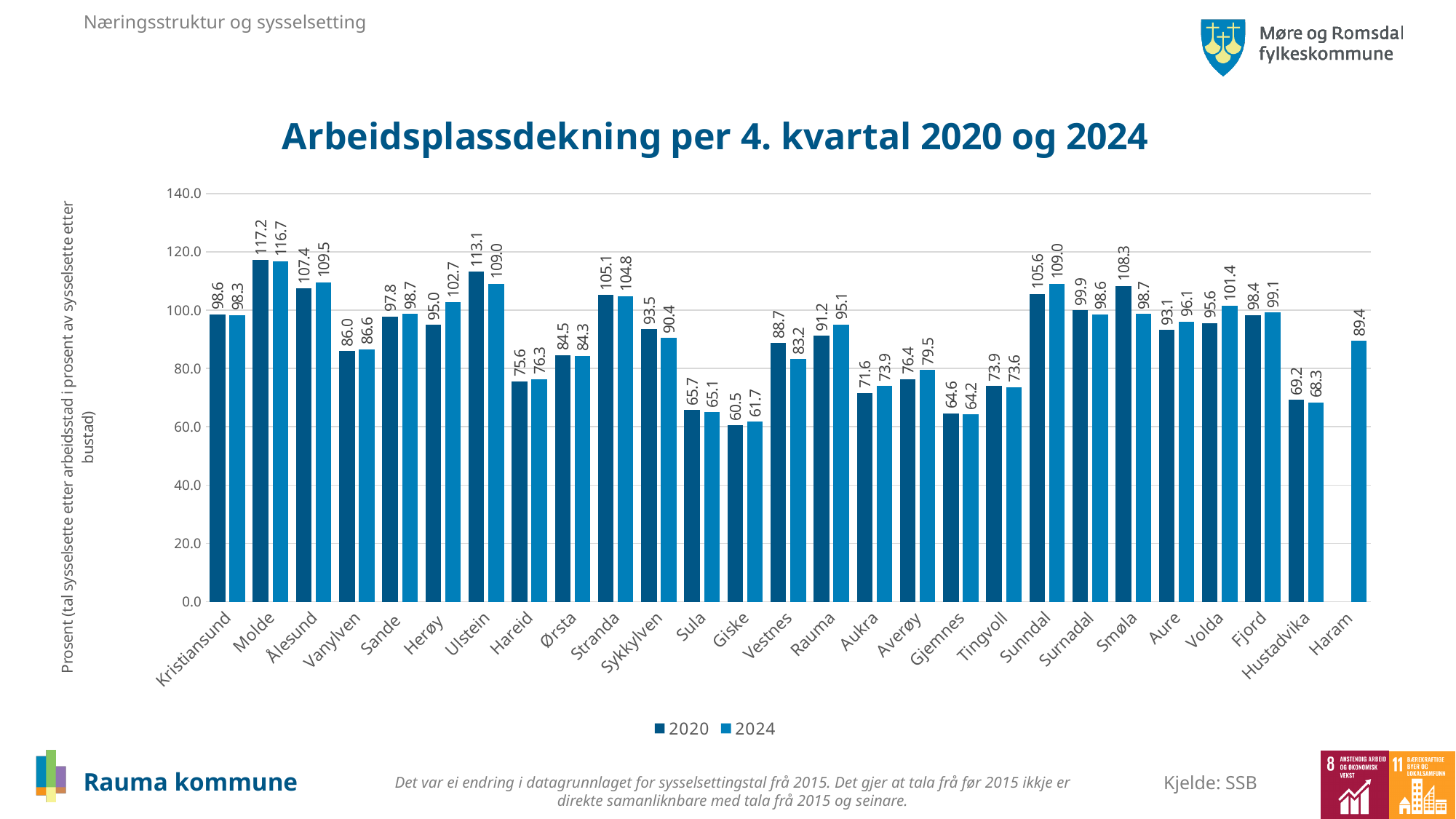
What is the 2024 value for Haram? 89.4 Which municipality has the lowest 2024 value? Giske Which municipality has the highest 2020 value? Molde What is the 2024 value for Rauma? 95.1 How many municipalities are shown on the x axis? 27 Is the 2020 value for Sunndal greater or less than 100? greater What is the title of the chart? Arbeidsplassdekning per 4. kvartal 2020 og 2024 What is the difference between the 2024 and 2020 values for Herøy? 7.7 What type of chart is shown on the slide? bar chart What is the 2020 value for Ulstein? 113.1 Which is larger for Smøla, the 2020 value or the 2024 value? 2020 How many series does the legend list? 2